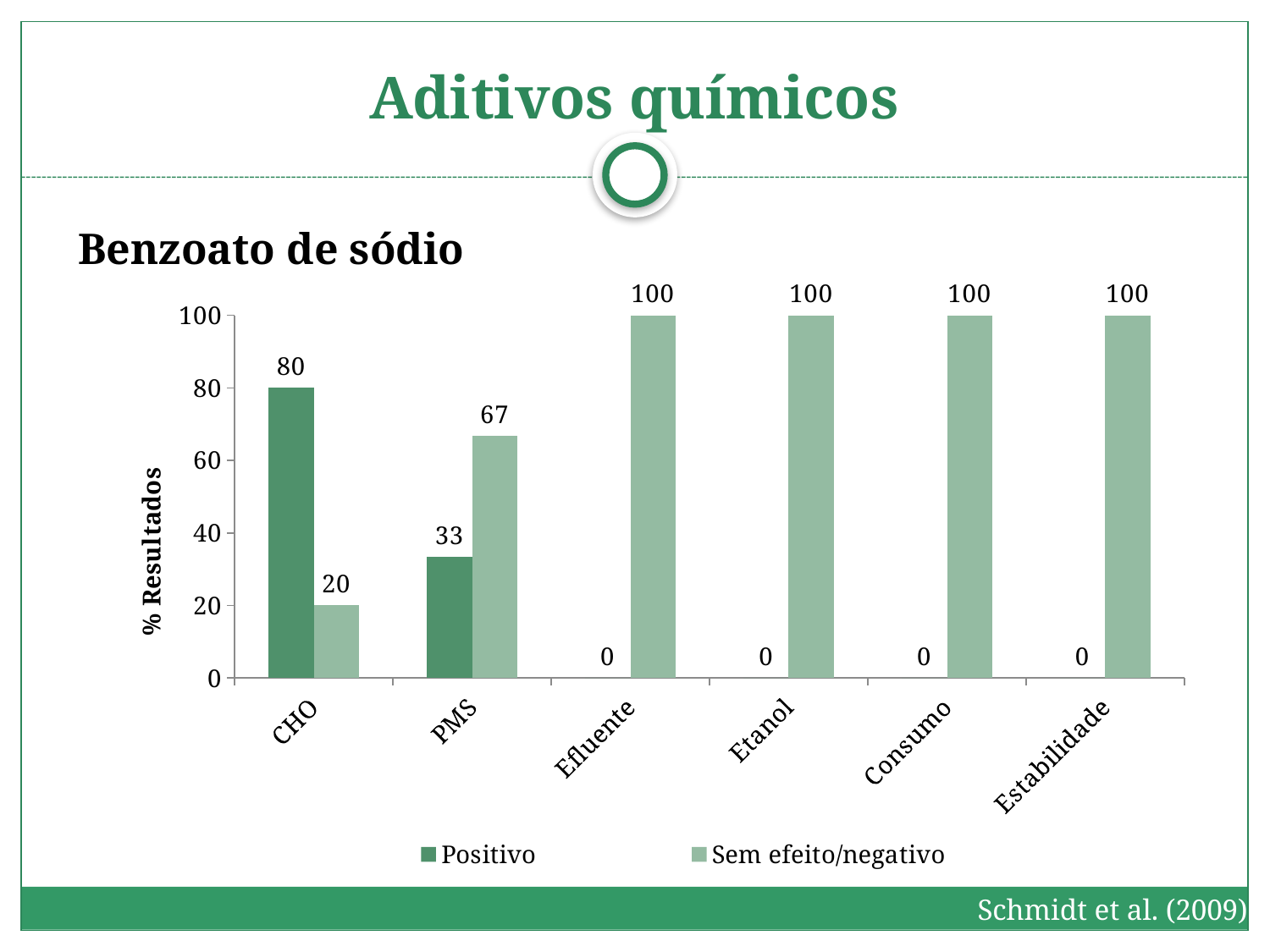
What is the Positivo value for CHO? 80 How many categories are shown on the x axis? 6 What is the Sem efeito/negativo value for PMS? 67 Which category has the lowest Sem efeito/negativo value? CHO For PMS, which is larger: the Positivo value or the Sem efeito/negativo value? Sem efeito/negativo What is the label of the y axis? % Resultados Which category has the highest Positivo value? CHO What kind of chart is shown on the slide? Bar chart What is the Sem efeito/negativo value for CHO? 20 How many series does the legend list? 2 What is the Positivo value for Etanol? 0 What is the difference between the Positivo and Sem efeito/negativo values for CHO? 60